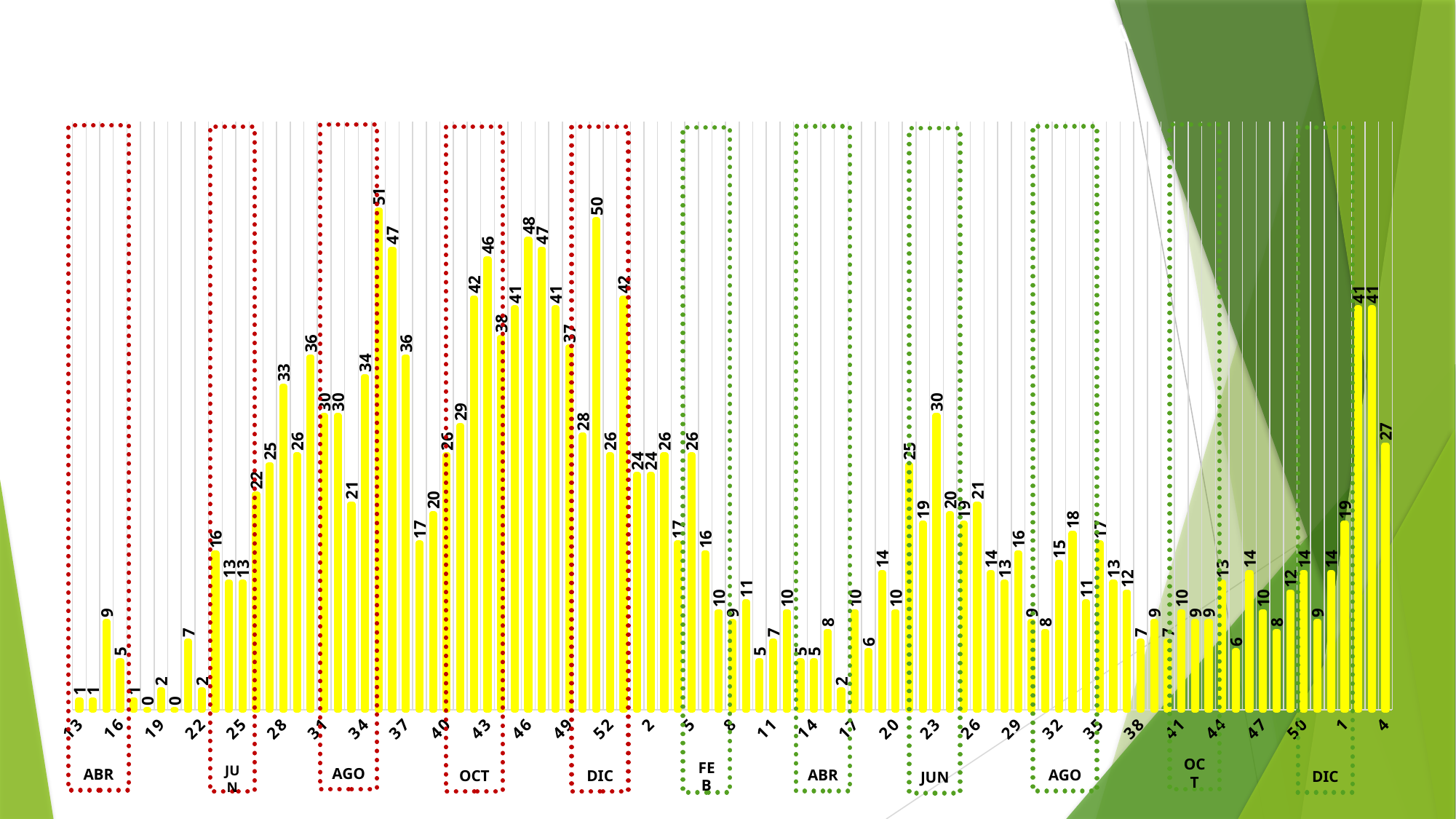
What is the value of the first bar on the left, at week 13? 1 What is the highest value shown by any bar on the chart? 51 What is the value of the tallest bar inside the green dotted JUN box? 30 What is the value of the last bar on the far right, at week 4? 27 What is the difference between the highest bar on the chart (51) and the tallest bar in the red DIC box (50)? 1 What is the value of the tallest bar inside the red dotted DIC box? 50 What is the lowest value shown by any bar on the chart? 0 What kind of chart is shown on the slide? bar chart What colour are the bars on the chart? yellow What is the value of the bar at week 46? 48 What is the value of the bar at week 28? 33